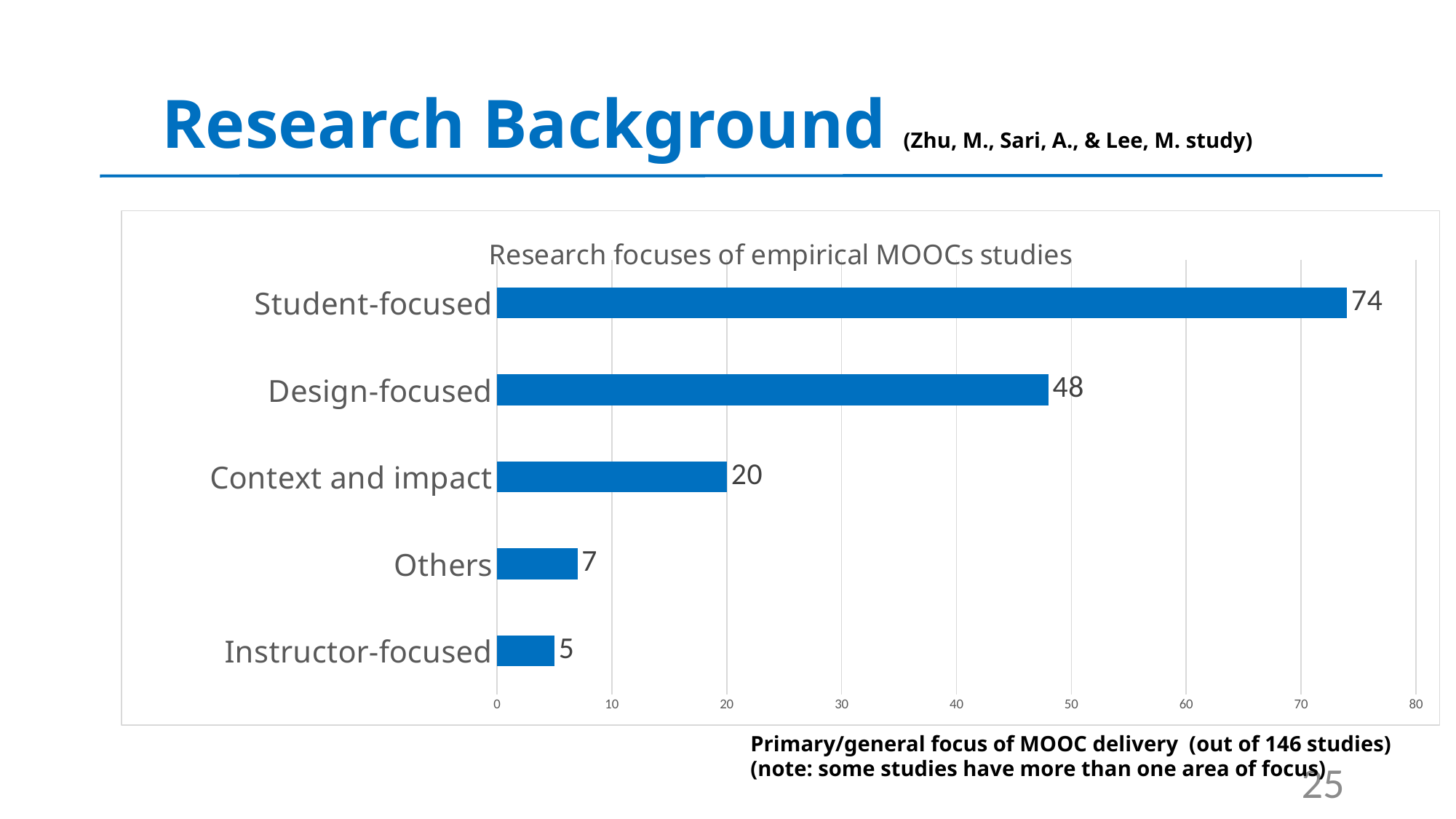
How many categories are shown in the chart? 5 What is the value for Context and impact? 20 What is the value for Design-focused? 48 What is the value for Student-focused? 74 What kind of chart is shown on the slide? Bar chart What is the title of the chart? Research focuses of empirical MOOCs studies Which category has the highest value? Student-focused Which is larger, the value for Context and impact or the value for Others? Context and impact What is the value for Instructor-focused? 5 What is the difference between the values for Others and Instructor-focused? 2 What is the difference between the values for Student-focused and Design-focused? 26 Which category has the lowest value? Instructor-focused